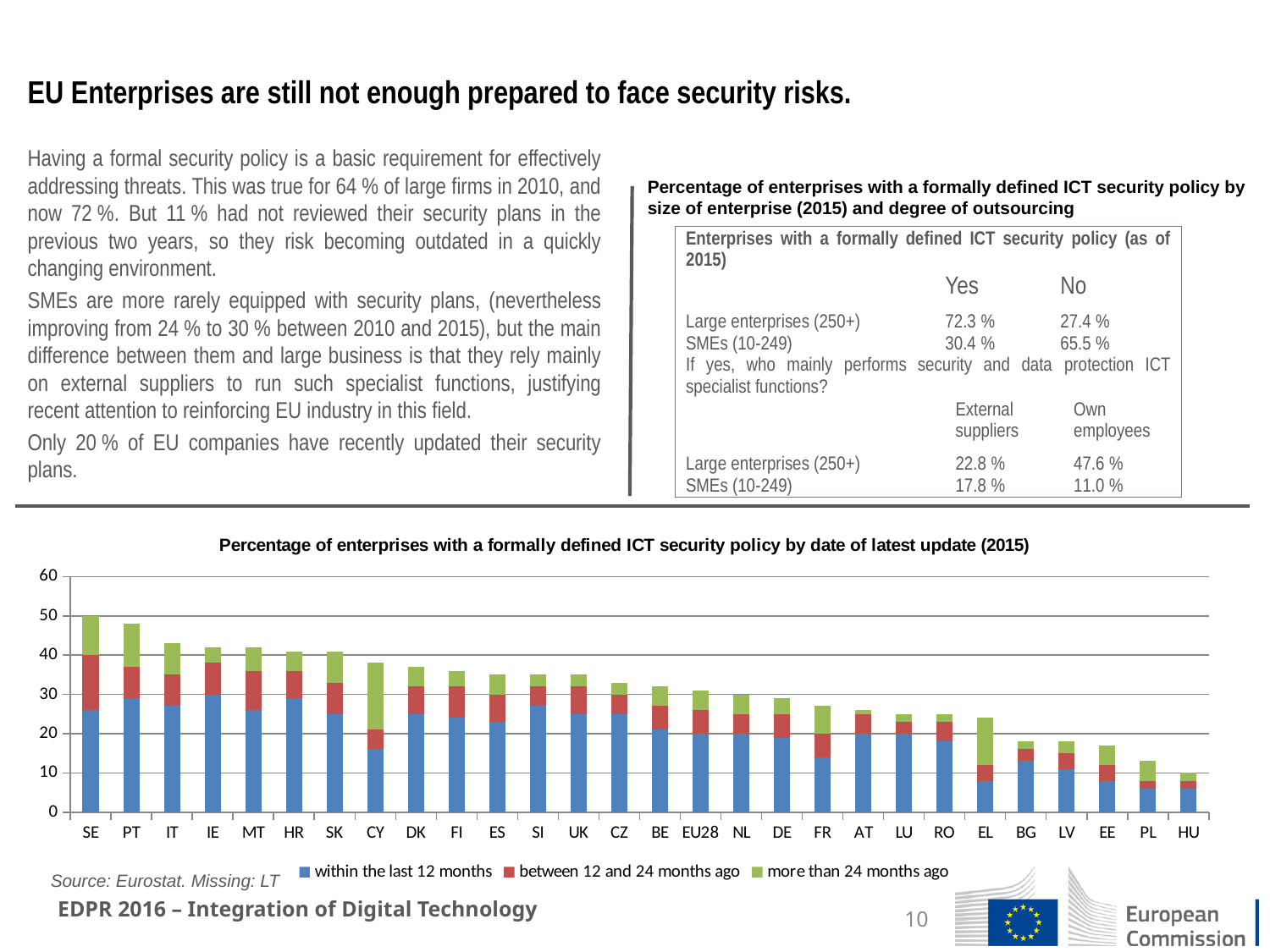
How many countries/categories are shown on the x axis of the bar chart? 28 Which has a taller stacked bar, PT or PL? PT Do the total stacked values generally rise or fall moving from left to right along the x axis? fall Which category has the tallest stacked bar in the chart? SE Is the total stacked value for SE greater or less than 40? greater Which legend entry is shown in green in the bar chart? more than 24 months ago Is the total stacked value for EU28 greater or less than 40? less What kind of chart is shown at the bottom of the slide? Stacked bar chart What is the title of the bar chart? Percentage of enterprises with a formally defined ICT security policy by date of latest update (2015) How many series does the legend of the bar chart list? 3 Which category has the shortest stacked bar in the chart? HU Is the total stacked value for HU greater or less than 20? less